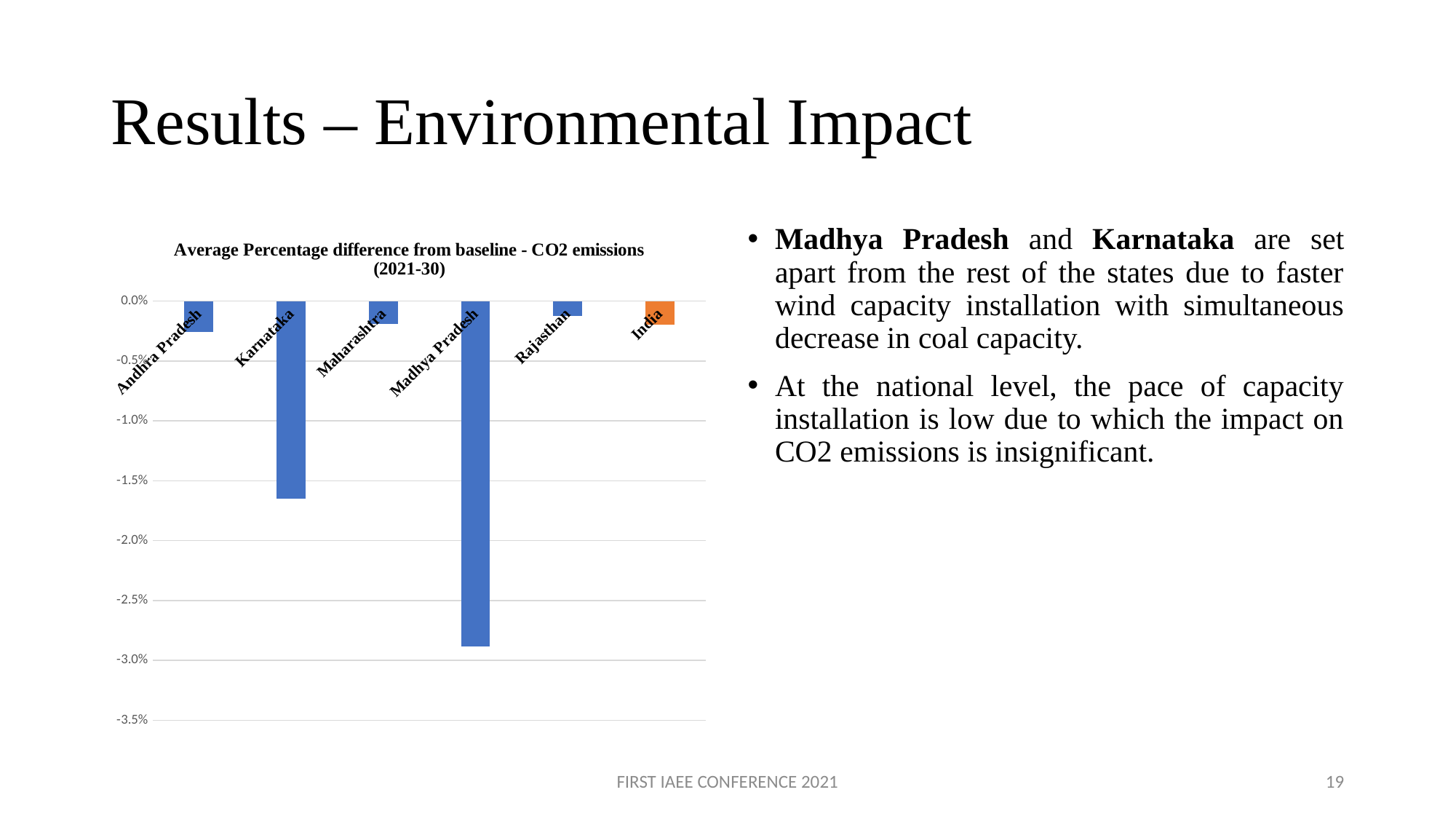
What kind of chart is shown on the slide? Bar chart Is the value for Andhra Pradesh greater or less than -0.5%? greater Which category has the larger decrease from baseline, Maharashtra or Madhya Pradesh? Madhya Pradesh Which category shows the largest percentage decrease from baseline in CO2 emissions? Madhya Pradesh Which category has the larger decrease from baseline, Andhra Pradesh or Karnataka? Karnataka Is the value for Karnataka greater or less than -1.5%? less How many categories are plotted in the chart? 6 Which category's bar is coloured orange rather than blue? India Which category has the larger decrease from baseline, Karnataka or Madhya Pradesh? Madhya Pradesh Is the value for Madhya Pradesh greater or less than -2.5%? less What is the title of the chart? Average Percentage difference from baseline - CO2 emissions (2021-30)